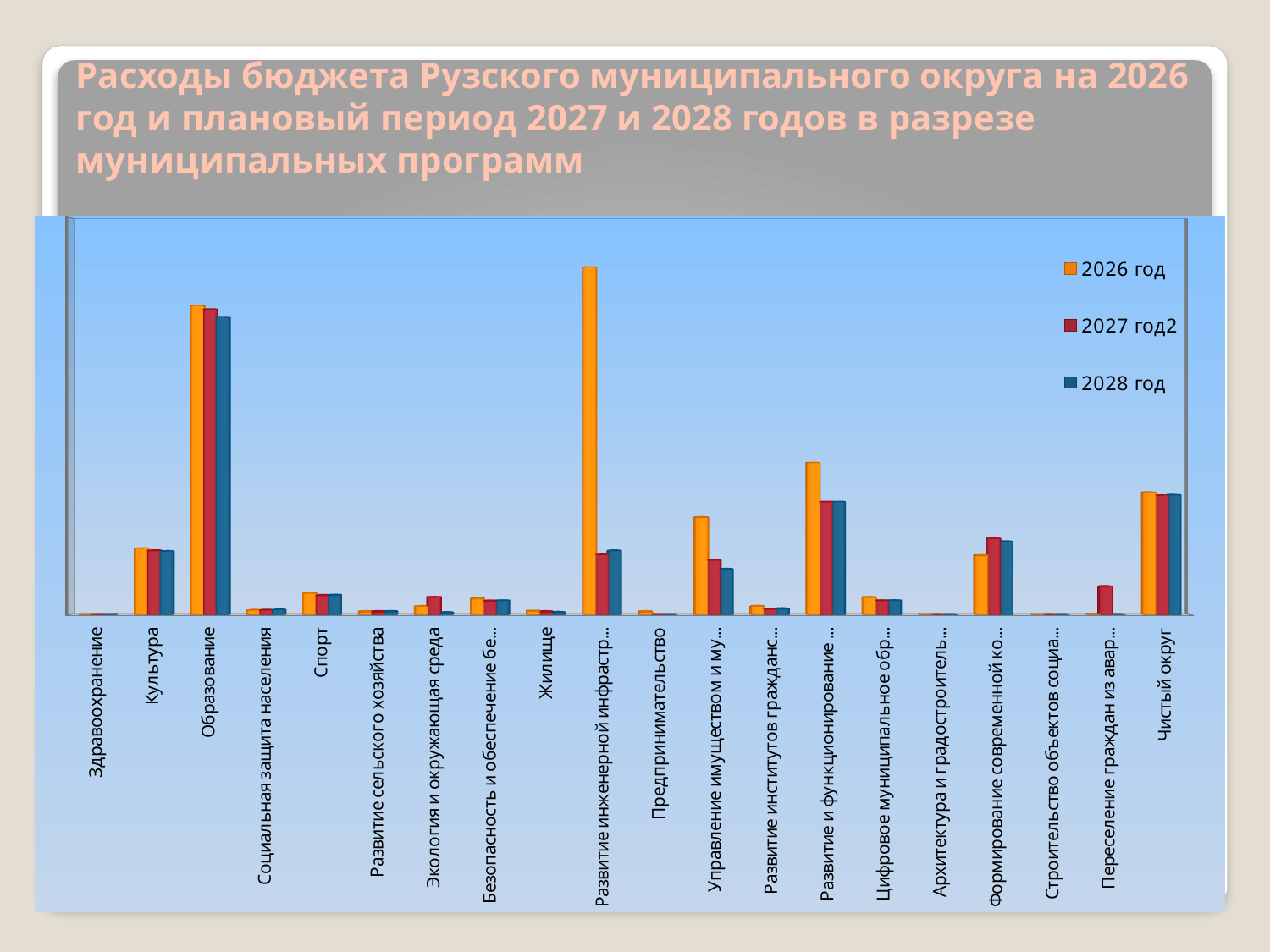
What kind of chart is shown on the slide? Bar chart What is the second series listed in the legend? 2027 год2 For Развитие инженерной инфрастр..., which series has the larger value: 2026 год or 2027 год2? 2026 год How many categories are shown along the x axis? 20 Which category has the highest value for the 2027 год2 series? Образование How many series does the legend list? 3 Which colour represents the 2026 год series in the legend? Orange For the 2028 год series, which is larger: Образование or Чистый округ? Образование Which category has the highest value for the 2028 год series? Образование Which category has the highest value for the 2026 год series? Развитие инженерной инфрастр... For Переселение граждан из авар..., which series has the larger value: 2027 год2 or 2028 год? 2027 год2